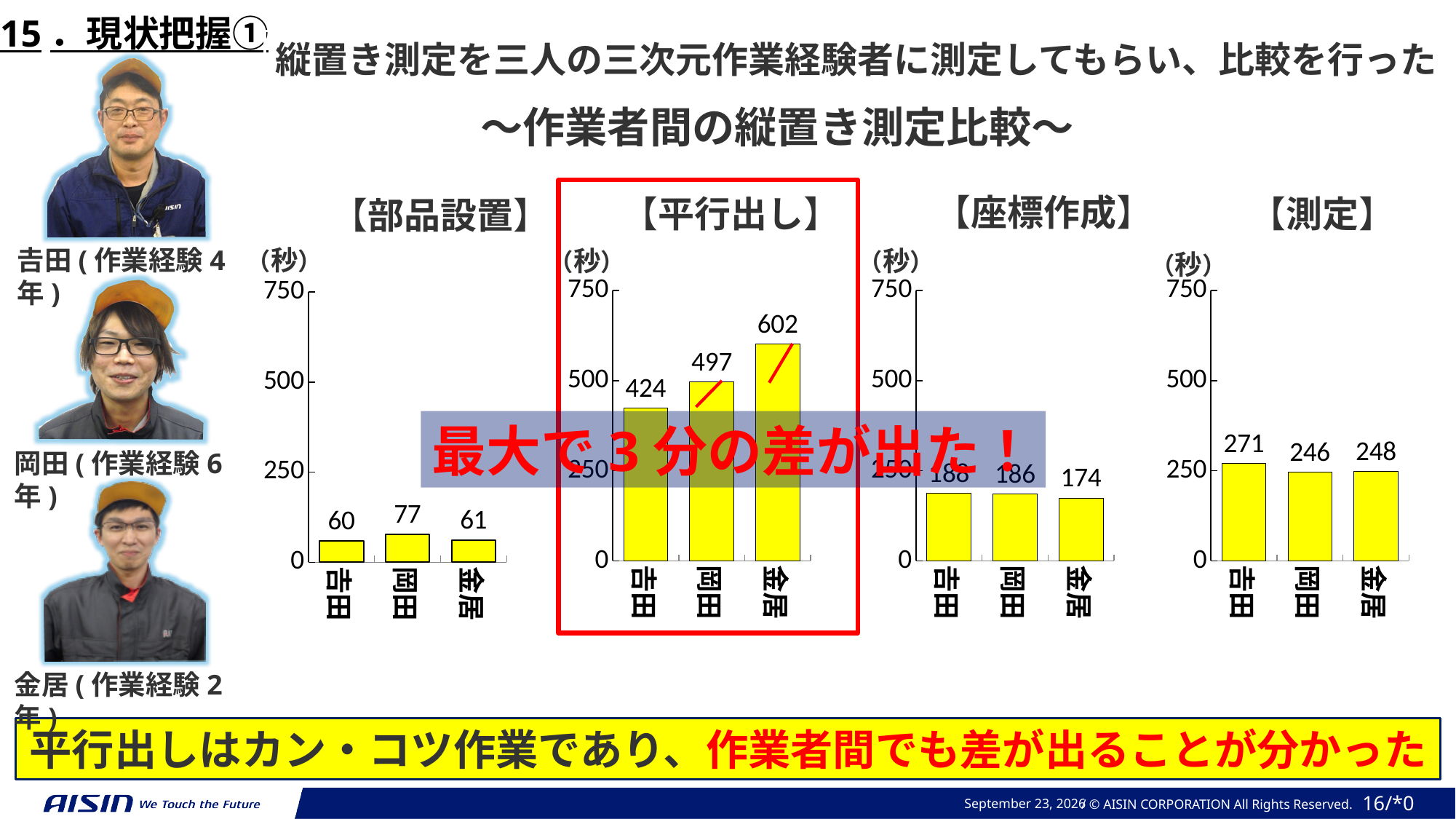
In the 【座標作成】 chart, what is the value for 金居? 174 In the 【平行出し】 chart, what is the difference between the values for 金居 and 吉田? 178 In the 【平行出し】 chart, what is the value for 金居? 602 In the 【平行出し】 chart, what is the value for 吉田? 424 In the 【測定】 chart, what is the value for 吉田? 271 In the 【測定】 chart, which is larger, the value for 吉田 or the value for 岡田? 吉田 In the 【平行出し】 chart, is the value for 岡田 greater or less than 250? greater In the 【平行出し】 chart, which worker has the highest value? 金居 In the 【部品設置】 chart, what is the value for 岡田? 77 In the 【部品設置】 chart, which worker has the lowest value? 吉田 What kind of chart is the 【座標作成】 chart? bar chart How many bars are in the 【測定】 chart? 3